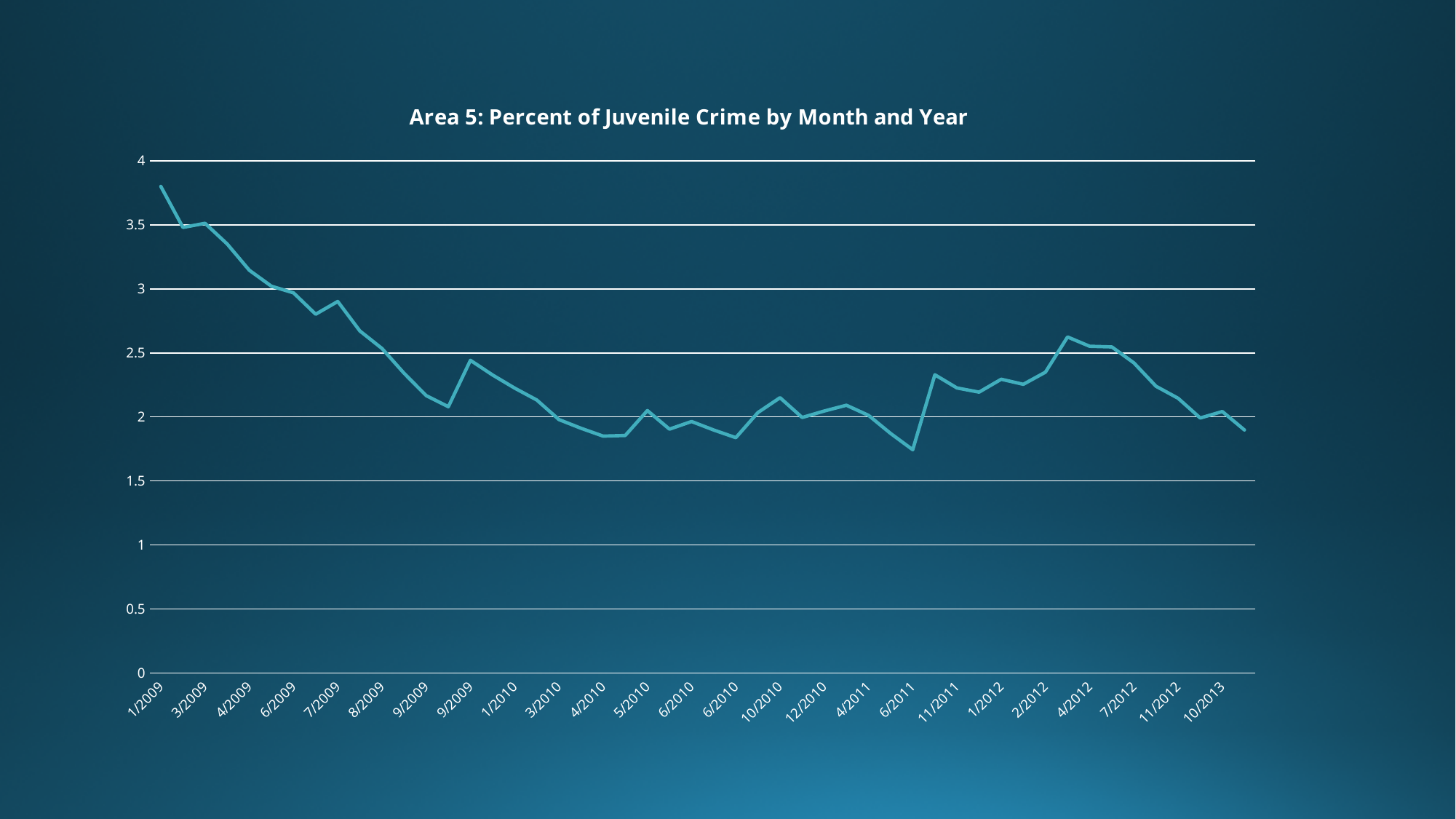
What kind of chart is shown on the slide? line chart Which is larger, the value for 1/2009 or the value for 10/2013? 1/2009 What is the title of the chart? Area 5: Percent of Juvenile Crime by Month and Year Is the value for 6/2011 greater or less than 2? less Which month/year has the lowest value on the chart? 6/2011 Is the value for 11/2011 greater or less than 2? greater Which month/year has the highest value on the chart? 1/2009 Is the value for 7/2009 greater or less than 3? less Overall, do the values rise or fall from 1/2009 to 10/2013? fall